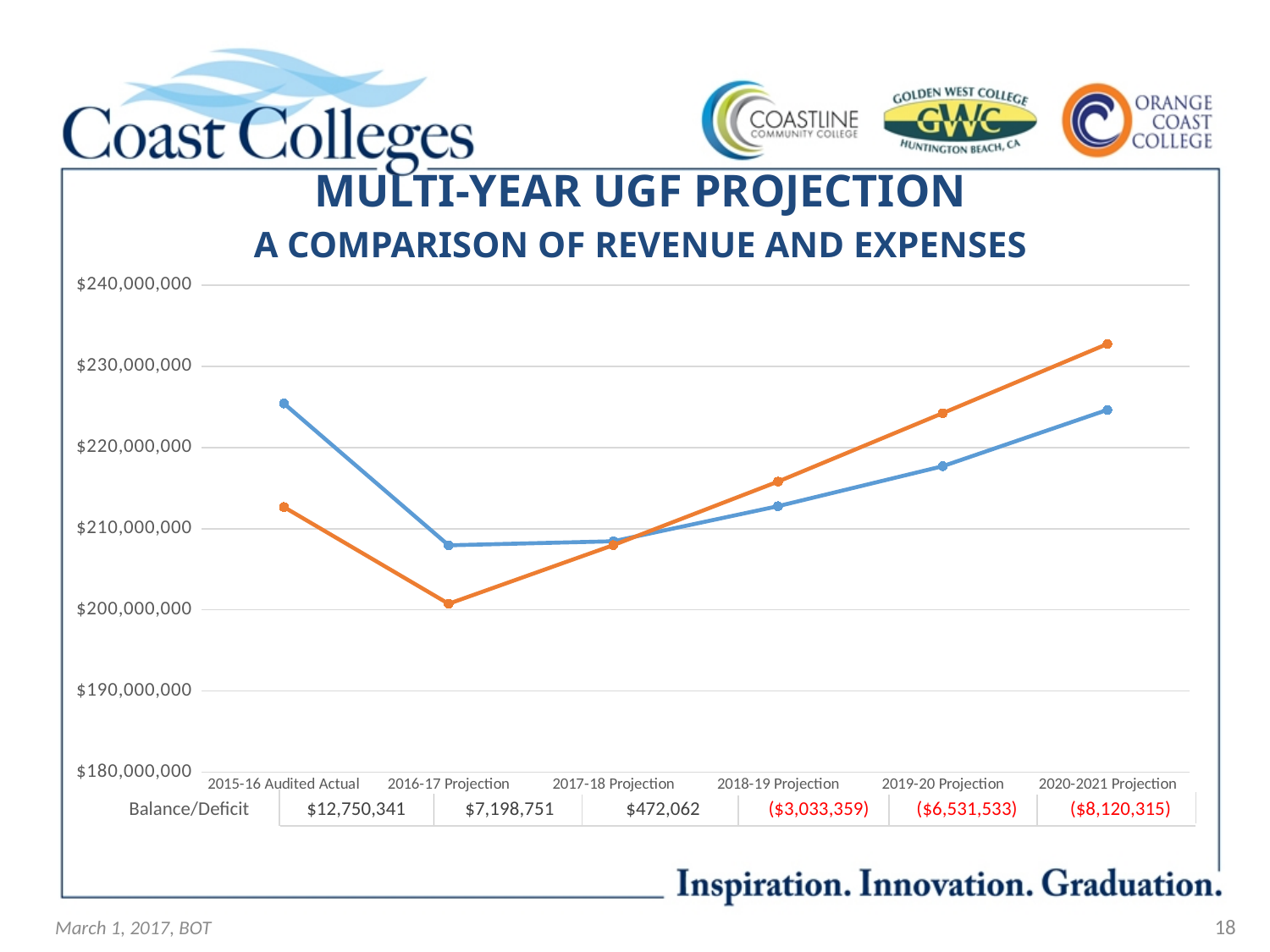
What is the difference between the Balance/Deficit for 2015-16 Audited Actual and 2016-17 Projection? $5,551,590 Which period has the lowest Balance/Deficit value in the table? 2020-2021 Projection Is the value of the orange line for 2016-17 Projection greater or less than $210,000,000? less What kind of chart is shown on the slide? Line chart At 2020-2021 Projection, which line is higher, the blue line or the orange line? The orange line Does the orange line rise or fall from 2016-17 Projection to 2020-2021 Projection? Rises Is the value of the blue line for 2015-16 Audited Actual greater or less than $220,000,000? greater What is the Balance/Deficit value shown for 2015-16 Audited Actual? $12,750,341 Which period has the highest Balance/Deficit value in the table? 2015-16 Audited Actual What is the Balance/Deficit value shown for 2017-18 Projection? $472,062 How many periods are plotted along the x axis? 6 What is the Balance/Deficit value shown for 2020-2021 Projection? ($8,120,315)